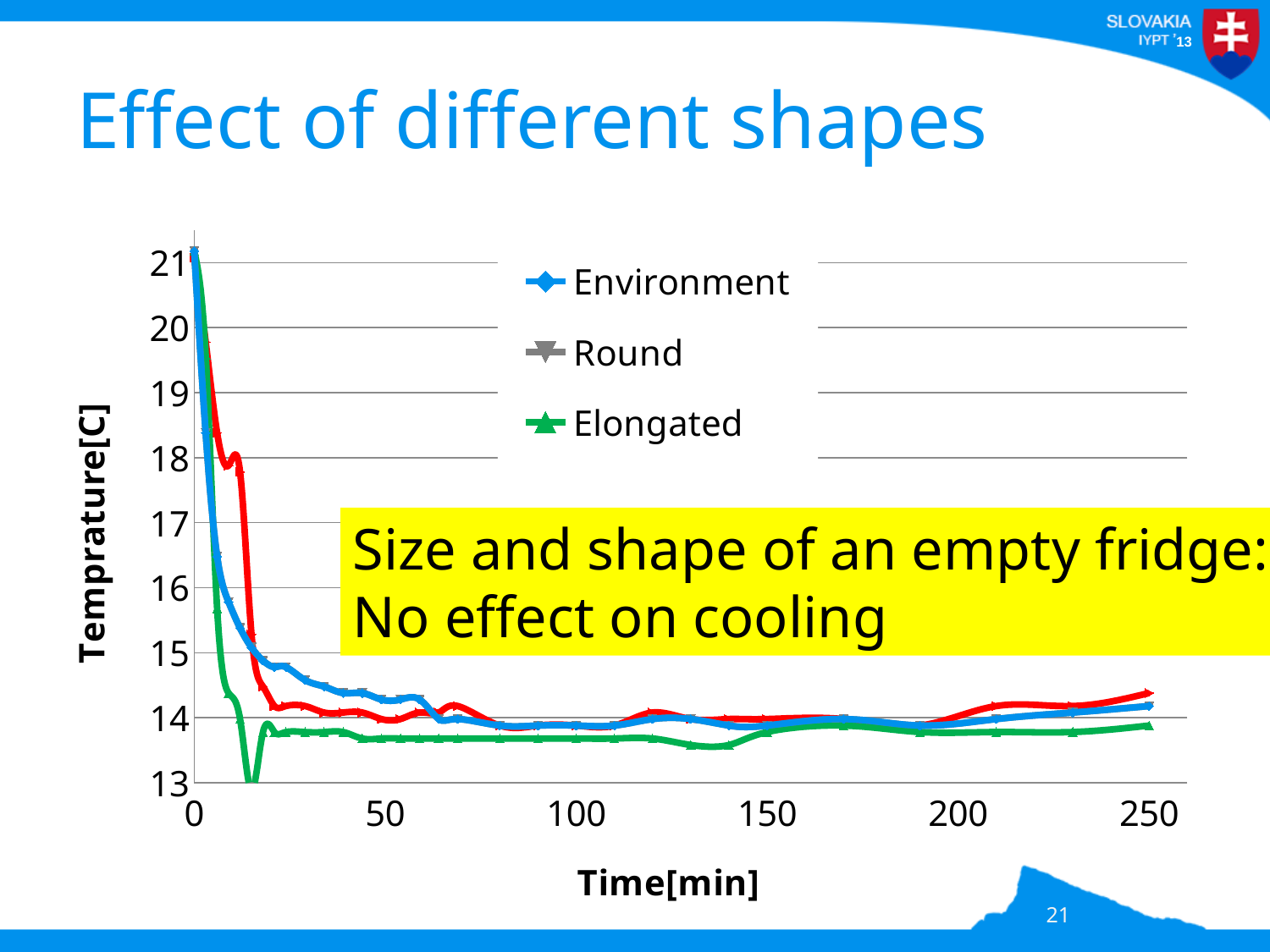
How many series does the legend list? 3 At 250 min, which is higher: Round or Elongated? Round Is the Elongated value at 150 min greater or less than 14? less Does the Environment temperature rise or fall over time along the x axis? fall At 10 min, which is higher: Round or Elongated? Round What is the label of the x axis? Time[min] What kind of chart is shown on the slide? line chart Is the Round value at 250 min greater or less than 14? greater Is the Elongated value at 100 min greater or less than 14? less What are the three series listed in the legend? Environment, Round, Elongated